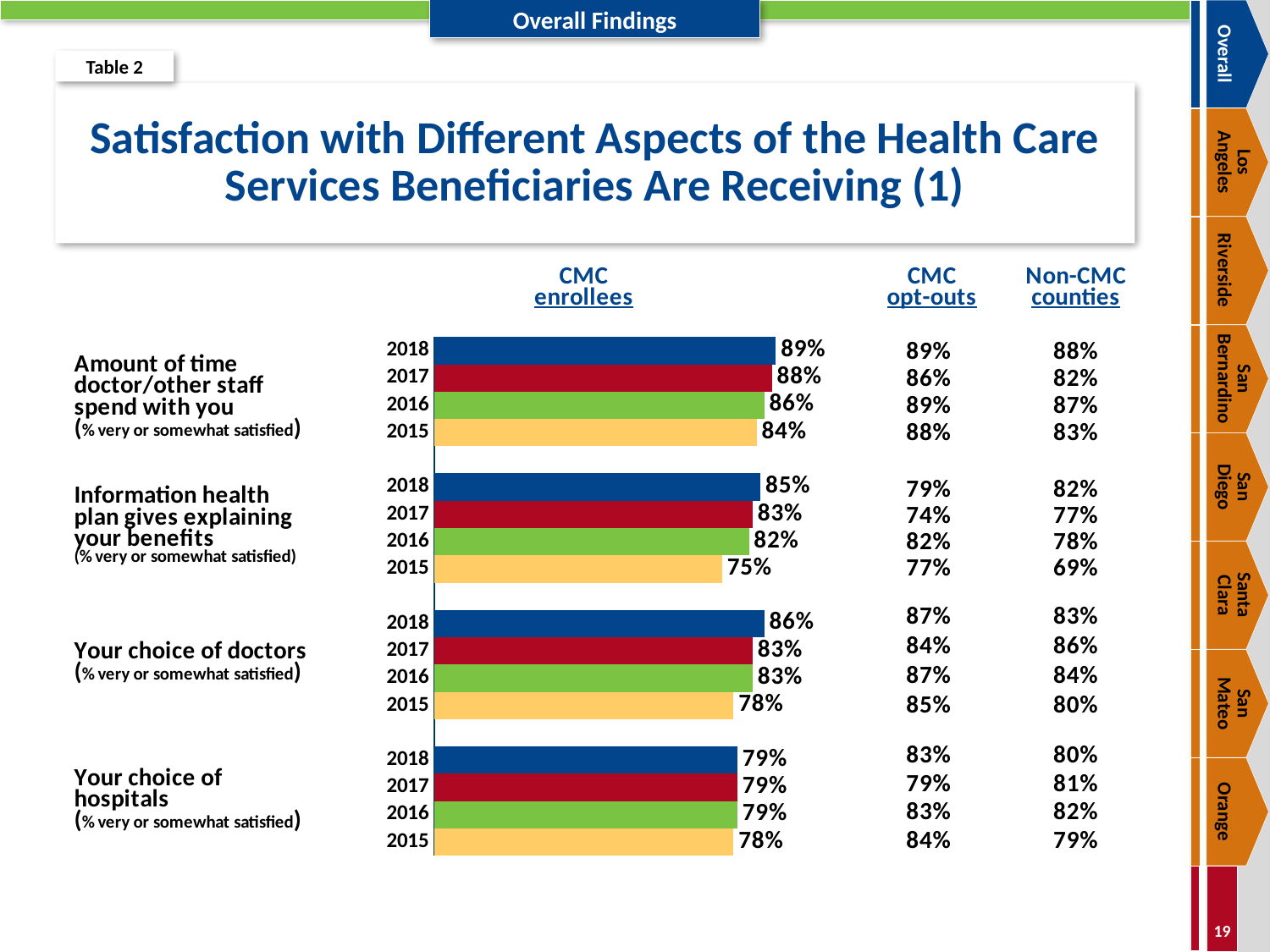
Which colour are the 2018 bars in the CMC enrollees chart? Blue What is the difference between the 2018 and 2015 CMC enrollees values for 'Information health plan gives explaining your benefits'? 10% What is the CMC enrollees value for 'Your choice of doctors' in 2016? 83% What is the CMC enrollees value for 'Amount of time doctor/other staff spend with you' in 2018? 89% How many years are shown as bars for each aspect in the CMC enrollees chart? 4 What is the difference between the 2018 and 2015 CMC enrollees values for 'Amount of time doctor/other staff spend with you'? 5% What kind of chart is used to show the CMC enrollees values? Bar chart Which year has the lowest CMC enrollees bar for 'Information health plan gives explaining your benefits'? 2015 Which year has the highest CMC enrollees bar for 'Your choice of doctors'? 2018 For CMC enrollees, which is larger: the 2018 value for 'Your choice of doctors' or the 2018 value for 'Your choice of hospitals'? Your choice of doctors What is the CMC enrollees value for 'Your choice of hospitals' in 2015? 78% What is the CMC enrollees value for 'Information health plan gives explaining your benefits' in 2015? 75%